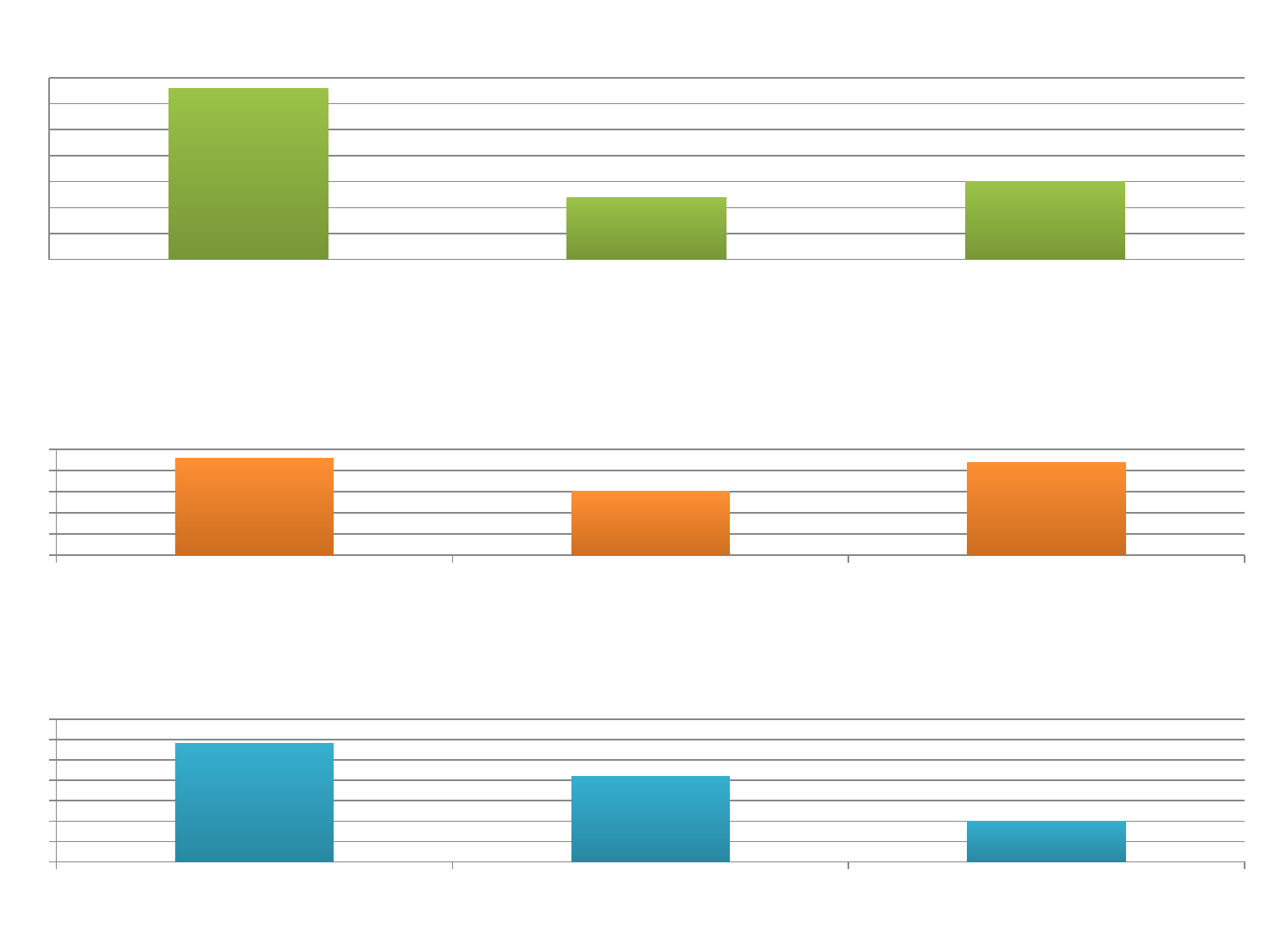
How many bars does the bottom chart show? 3 In the bottom chart, which bar is the shortest: the left, middle, or right one? right What colour are the bars in the bottom chart? blue What colour are the bars in the middle chart? orange In the bottom chart, do the bar heights rise or fall from left to right? fall In the middle chart, which bar is the tallest: the left, middle, or right one? left In the middle chart, which bar is the shortest: the left, middle, or right one? middle In the top chart, which bar is the shortest: the left, middle, or right one? middle How many bars does the top chart show? 3 In the top chart, which bar is the tallest: the left, middle, or right one? left In the top chart, is the middle bar or the right bar taller? right What kind of chart is the top chart on the slide? bar chart